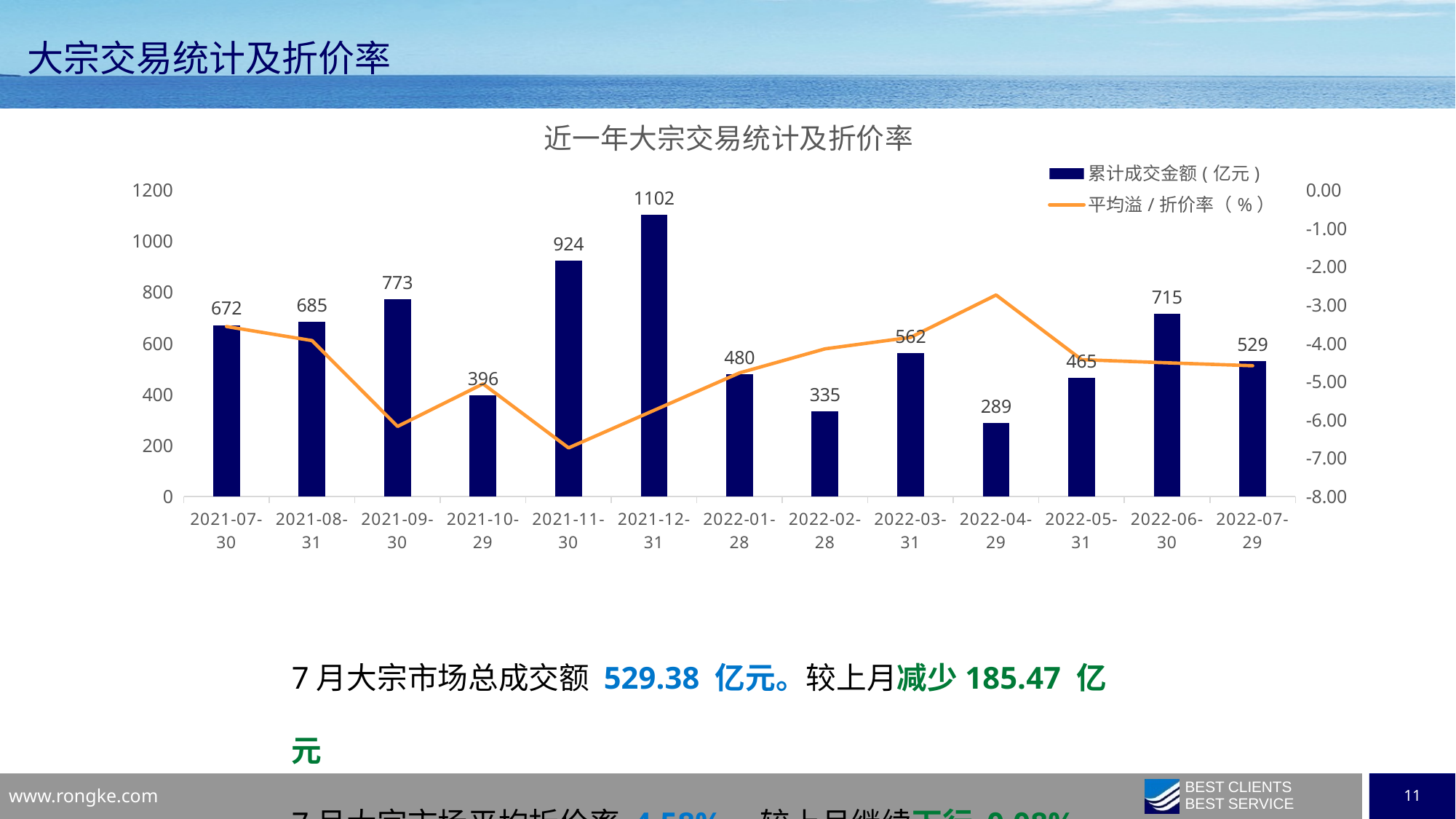
What is the title of the chart? 近一年大宗交易统计及折价率 Which has a larger 累计成交金额, 2021-09-30 or 2022-06-30? 2021-09-30 Is the 平均溢/折价率 value for 2021-11-30 greater or less than -6.00? less What is the 累计成交金额 value for 2022-07-29? 529 Which date has the highest 累计成交金额? 2021-12-31 How many dates are shown on the x axis? 13 What is the 累计成交金额 value for 2022-02-28? 335 What is the difference in 累计成交金额 between 2022-06-30 and 2022-07-29? 186 What is the 累计成交金额 value for 2021-12-31? 1102 How many series does the legend list? 2 Which date has the lowest 累计成交金额? 2022-04-29 What is the difference in 累计成交金额 between 2021-12-31 and 2021-11-30? 178